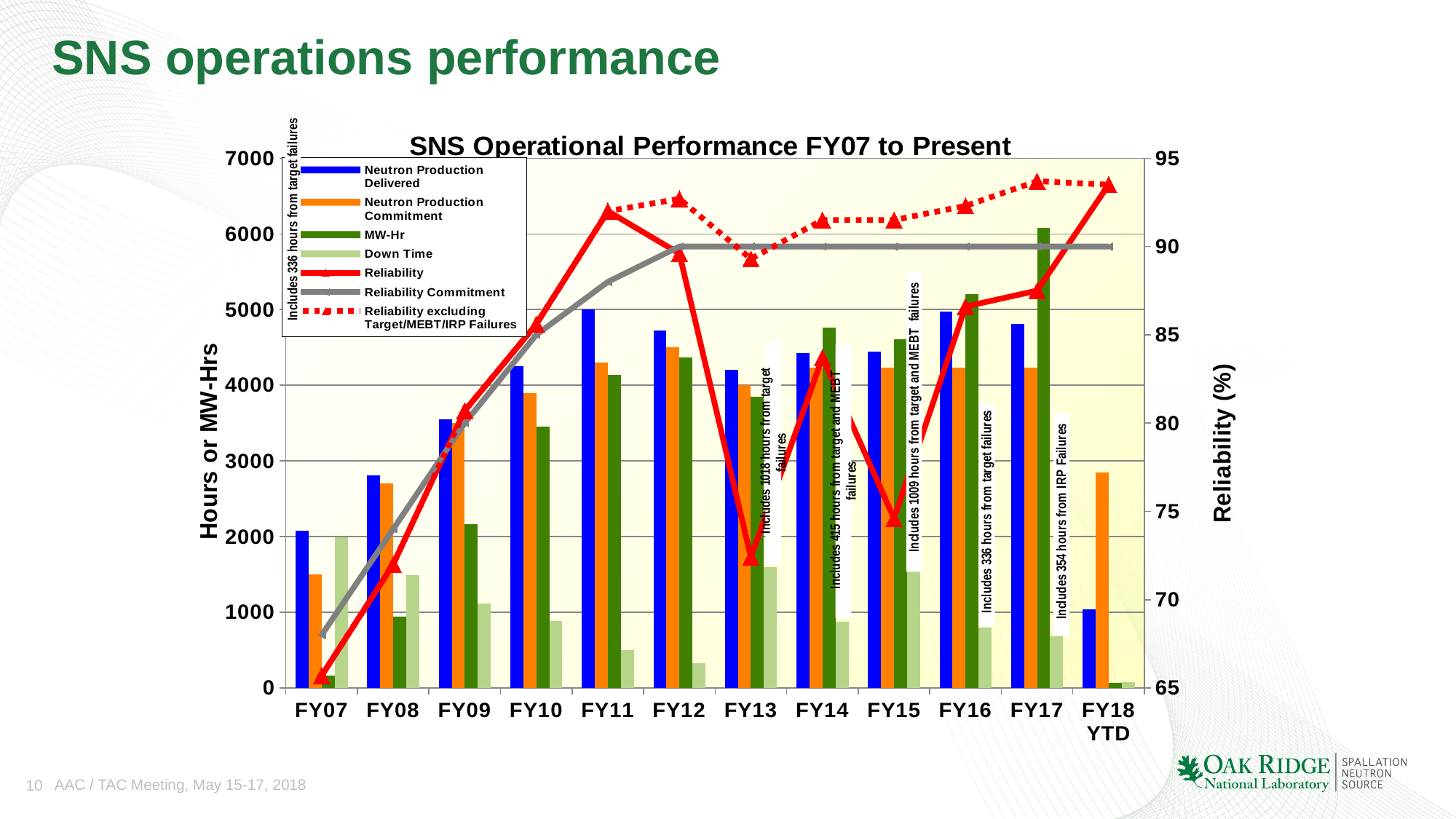
How many fiscal-year categories are shown on the x axis? 12 In which fiscal year is Down Time highest? FY07 Is the Reliability value for FY13 greater or less than 75? less In which fiscal year is MW-Hr highest? FY17 How many series does the legend list? 7 In which fiscal year is Neutron Production Delivered lowest? FY18 YTD What is the title of the chart? SNS Operational Performance FY07 to Present In FY17, which is larger: MW-Hr or Neutron Production Delivered? MW-Hr Is the Neutron Production Delivered value for FY11 greater or less than 4000? greater What kind of chart is shown on the slide? Combined bar and line chart In which fiscal year is Reliability lowest? FY07 What is the label of the right-hand vertical axis? Reliability (%)